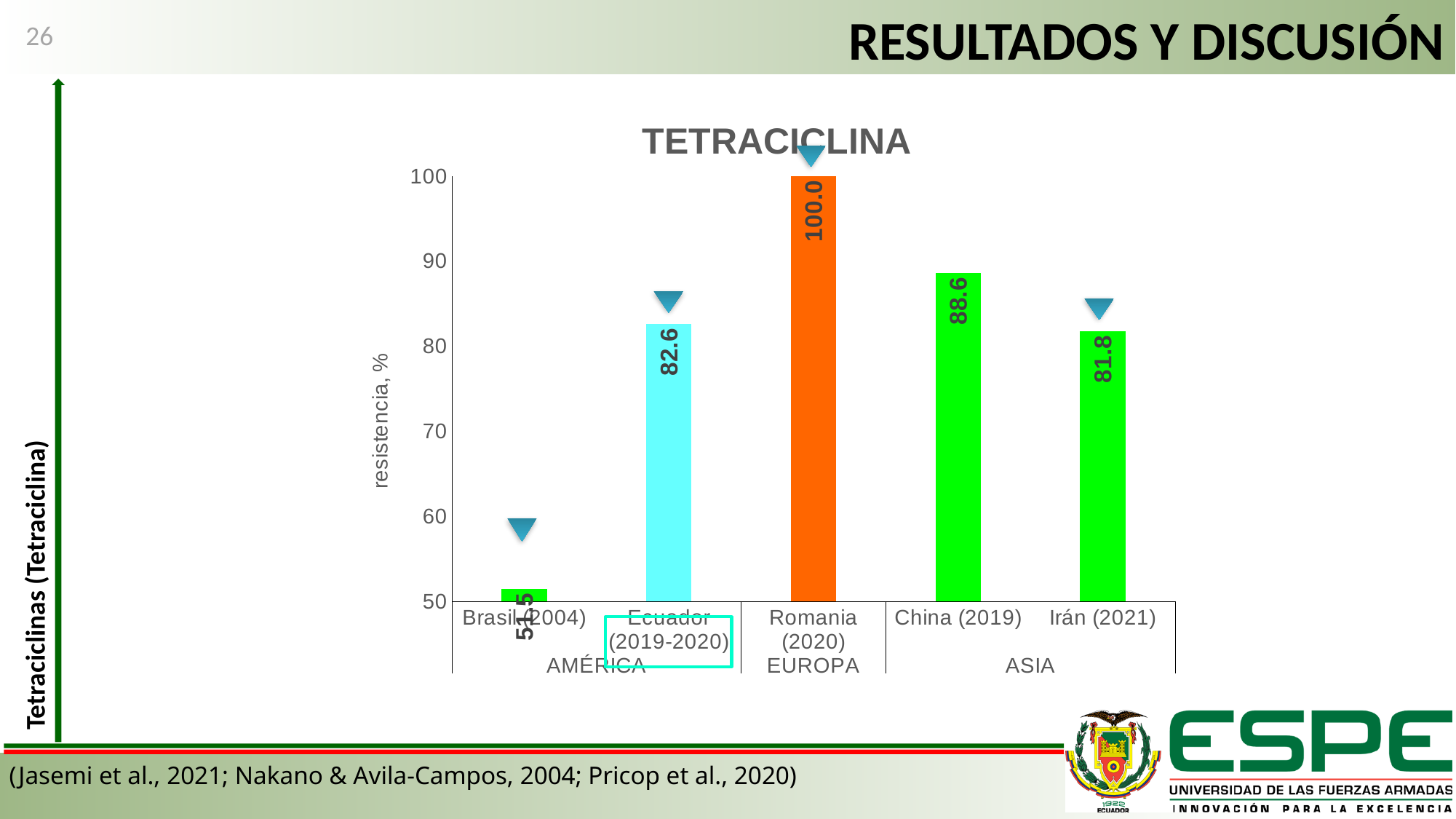
Which has a higher value, Ecuador (2019-2020) or Irán (2021)? Ecuador (2019-2020) What is the resistance value for Romania (2020)? 100.0 What kind of chart is shown on the slide? bar chart What is the resistance value for China (2019)? 88.6 What is the resistance value for Ecuador (2019-2020) in the TETRACICLINA chart? 82.6 What is the difference between the values for China (2019) and Ecuador (2019-2020)? 6.0 How many bars are shown in the TETRACICLINA chart? 5 Is the value for Brasil (2004) greater or less than 60? less Which country has the highest tetracycline resistance in the chart? Romania (2020) Which country has the lowest tetracycline resistance in the chart? Brasil (2004) What is the label of the vertical axis of the chart? resistencia, % What is the resistance value for Irán (2021)? 81.8